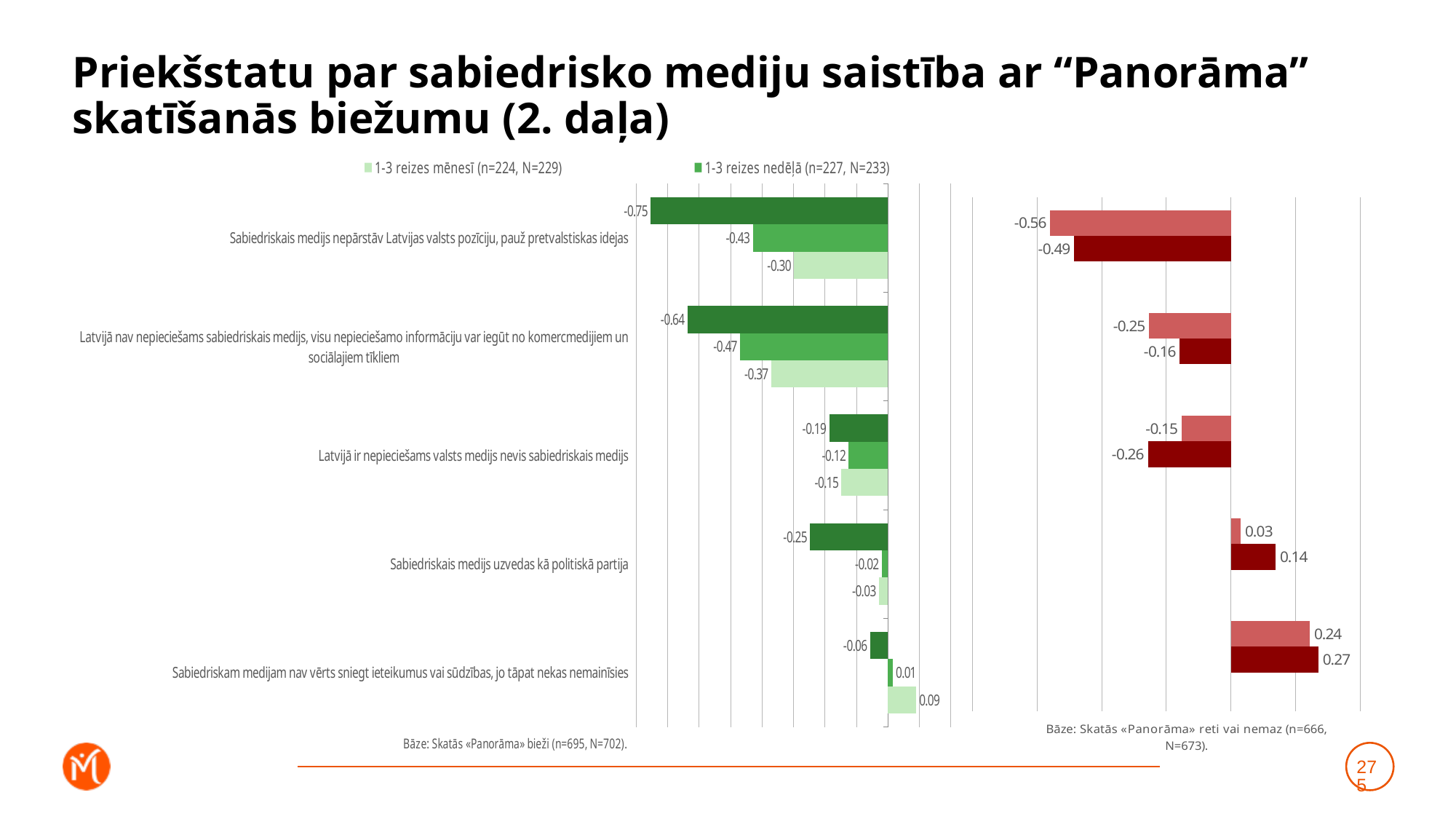
What kind of chart is the left (green) chart? bar chart In the right (red) chart, what is the value of the dark red bar for "Latvijā ir nepieciešams valsts medijs nevis sabiedriskais medijs"? -0.26 In the left (green) chart, what is the value of the "1-3 reizes mēnesī" series for "Sabiedriskam medijam nav vērts sniegt ieteikumus vai sūdzības, jo tāpat nekas nemainīsies"? 0.09 In the left (green) chart, what is the difference between the "1-3 reizes mēnesī" and "1-3 reizes nedēļā" values for "Sabiedriskais medijs nepārstāv Latvijas valsts pozīciju, pauž pretvalstiskas idejas"? 0.13 How many categories are shown in the left (green) chart? 5 What is the first legend entry shown above the left (green) chart? 1-3 reizes mēnesī (n=224, N=229) In the left (green) chart, which category has the highest value for the "1-3 reizes mēnesī" series? Sabiedriskam medijam nav vērts sniegt ieteikumus vai sūdzības, jo tāpat nekas nemainīsies In the left (green) chart, what is the value of the "1-3 reizes nedēļā" series for "Sabiedriskais medijs uzvedas kā politiskā partija"? -0.02 In the right (red) chart, what is the value of the lighter red bar for "Sabiedriskais medijs nepārstāv Latvijas valsts pozīciju, pauž pretvalstiskas idejas"? -0.56 In the right (red) chart, what is the difference between the two bars for "Sabiedriskais medijs nepārstāv Latvijas valsts pozīciju, pauž pretvalstiskas idejas"? 0.07 In the right (red) chart, for "Sabiedriskam medijam nav vērts sniegt ieteikumus vai sūdzības, jo tāpat nekas nemainīsies", which bar is larger: the lighter red bar or the dark red bar? the dark red bar In the left (green) chart, which category has the lowest value for the "1-3 reizes nedēļā" series? Latvijā nav nepieciešams sabiedriskais medijs, visu nepieciešamo informāciju var iegūt no komercmedijiem un sociālajiem tīkliem